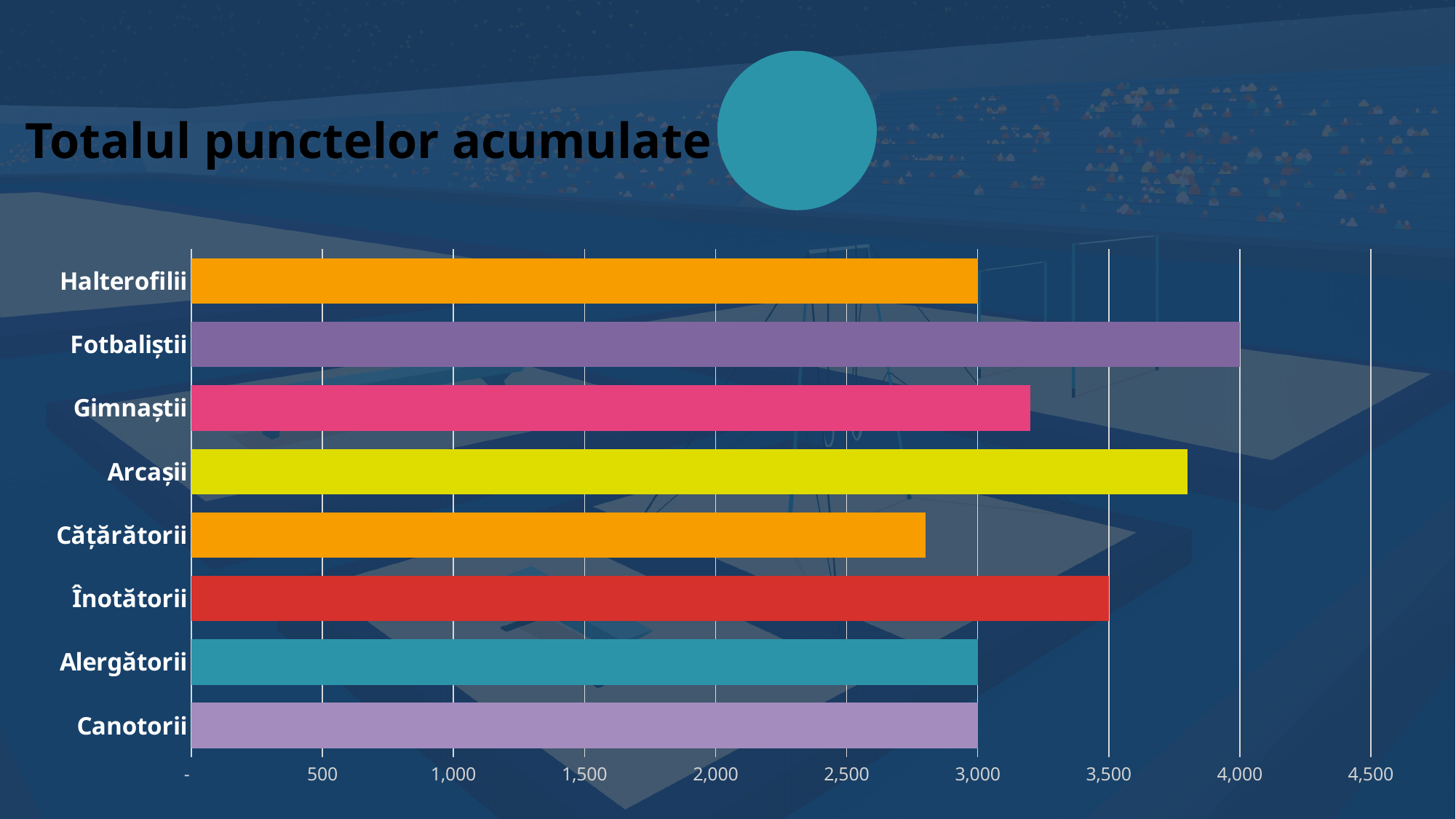
Is the value for Gimnaștii greater or less than 3,000? greater Which team has the highest total of points? Fotbaliștii What is the title of the chart? Totalul punctelor acumulate How many categories (teams) are shown in the chart? 8 What is the difference between the values for Fotbaliștii and Înotătorii? 500 Is the value for Cățărătorii greater or less than 3,000? less What kind of chart is shown on the slide? bar chart Which is larger, the value for Arcașii or the value for Gimnaștii? Arcașii What is the value for Fotbaliștii? 4,000 Which team has the lowest total of points? Cățărătorii What is the value for Înotătorii? 3,500 What is the value for Halterofilii? 3,000